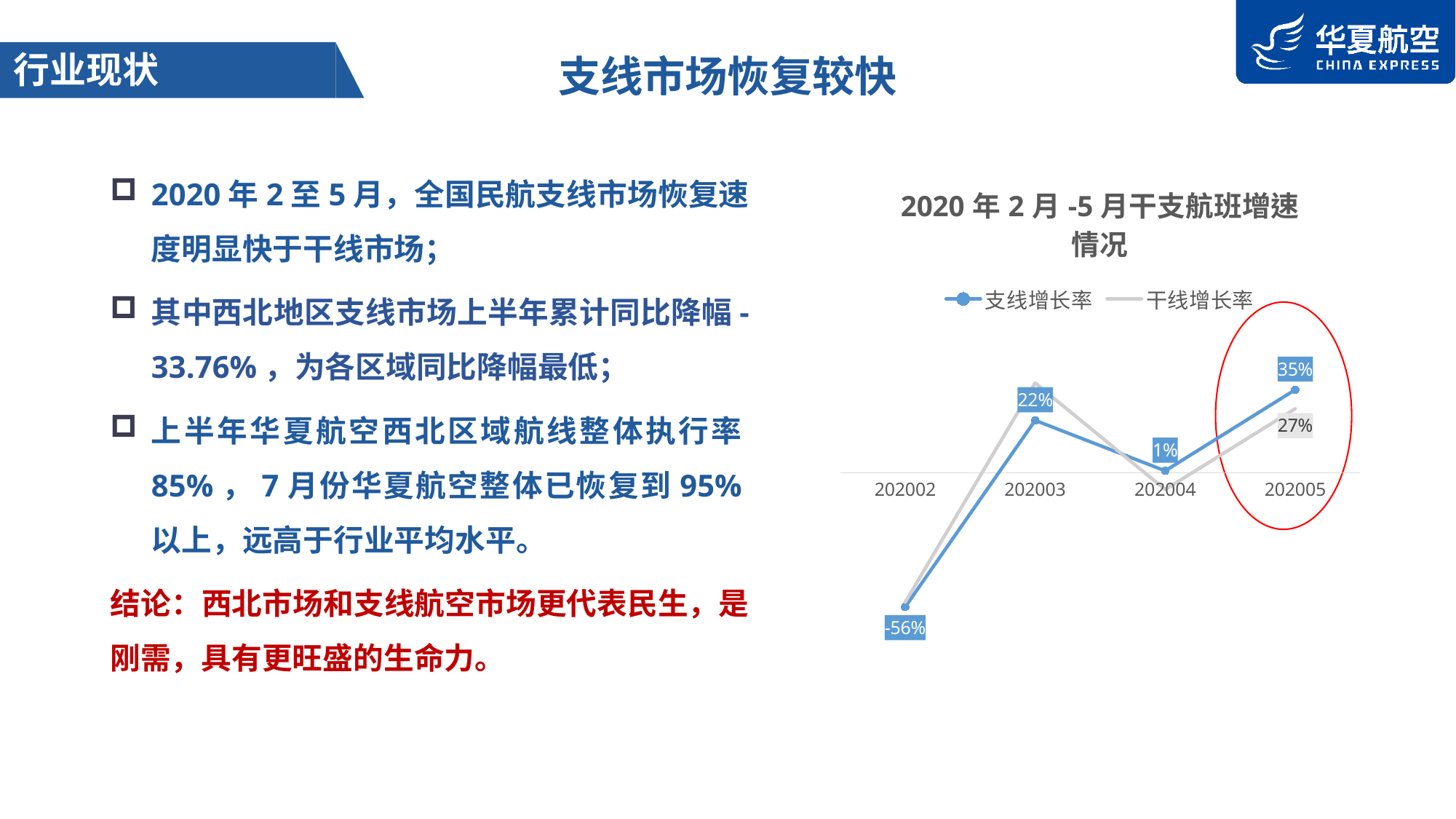
What is the difference between the 支线增长率 and 干线增长率 values for 202005? 8 percentage points What is the title of the chart? 2020年2月-5月干支航班增速情况 What is the 干线增长率 value for 202005? 27% How many months are plotted on the x axis of the chart? 4 What kind of chart is shown on the slide? Line chart How many series does the chart legend list? 2 What is the 支线增长率 value for 202003? 22% In which month is the 支线增长率 highest? 202005 In which month is the 支线增长率 lowest? 202002 What is the 支线增长率 value for 202005? 35% What is the 支线增长率 value for 202002? -56% For 202005, which is larger: 支线增长率 or 干线增长率? 支线增长率